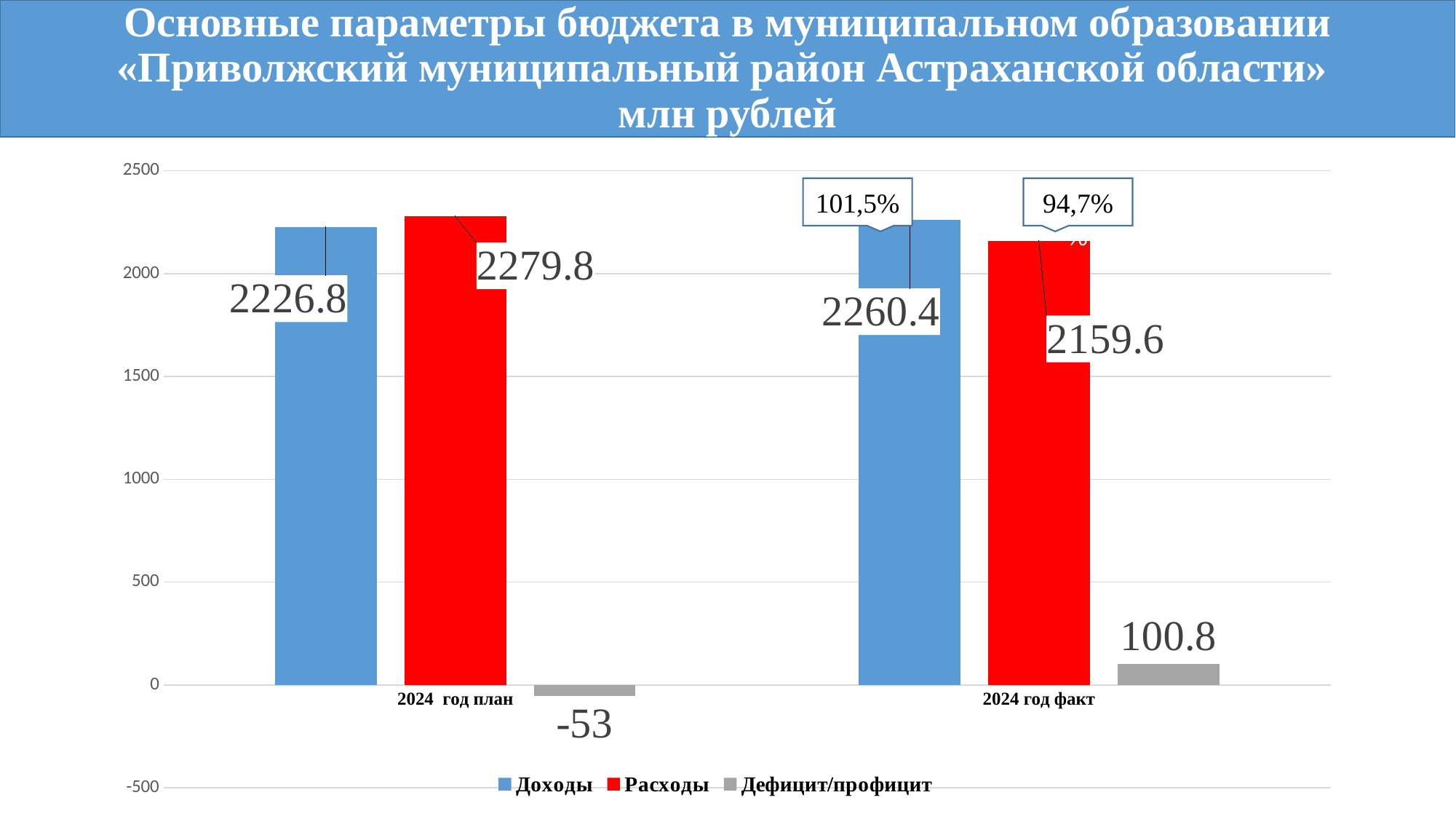
What is the difference between Расходы and Доходы for 2024 год план? 53 What is the value of Расходы for 2024 год факт? 2159.6 How many categories are shown on the x axis? 2 Which series has the lowest value in the 2024 год факт category? Дефицит/профицит Which is larger for 2024 год факт: Доходы or Расходы? Доходы What kind of chart is shown on the slide? Bar chart What is the difference between Доходы for 2024 год факт and Доходы for 2024 год план? 33.6 How many series does the legend list? 3 Which series has the highest value in the 2024 год план category? Расходы What is the value of Дефицит/профицит for 2024 год план? -53 What is the value of Доходы for 2024 год план? 2226.8 What is the value of Дефицит/профицит for 2024 год факт? 100.8